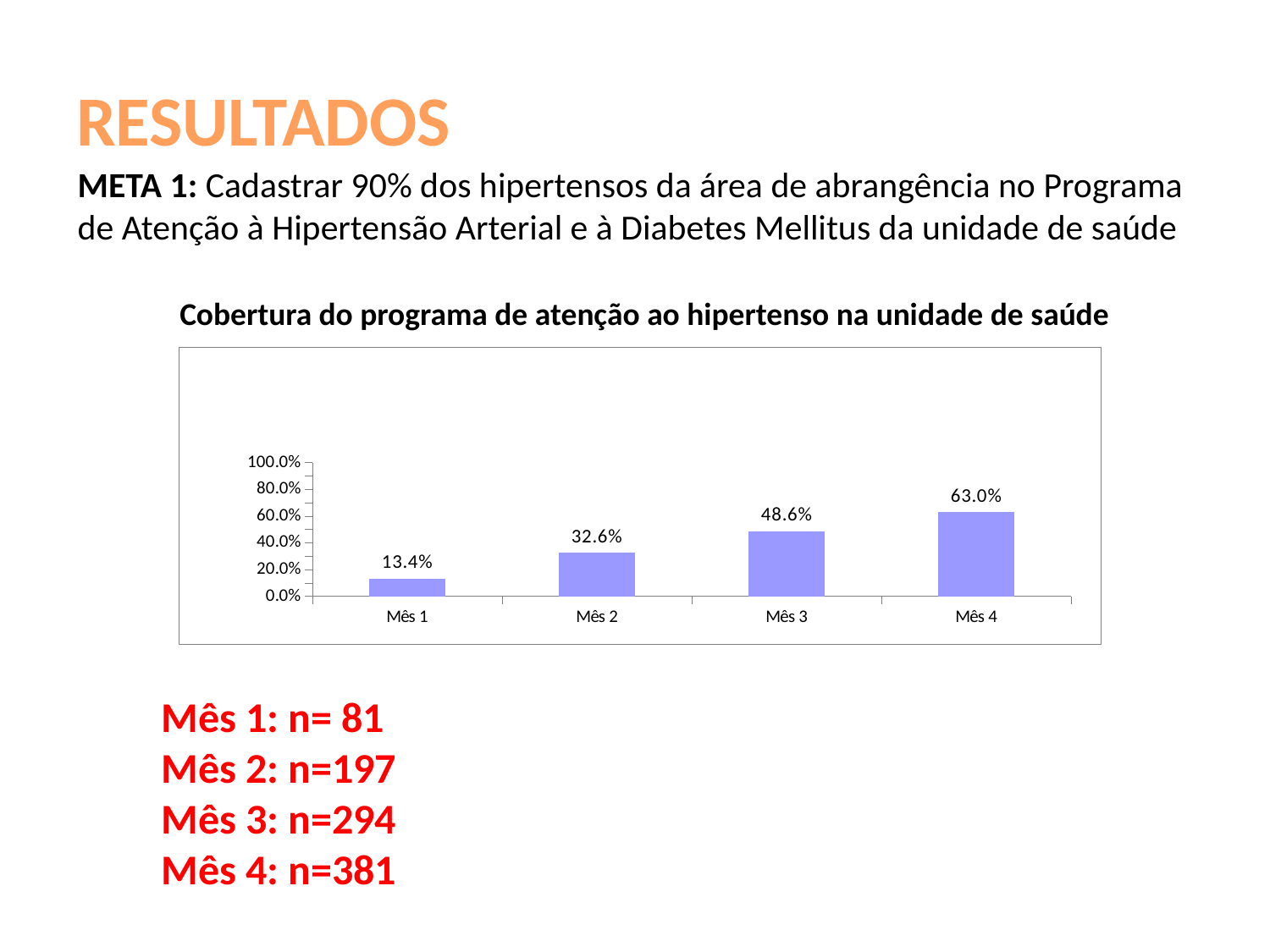
What is the value for Mês 4? 63.0% Which month has the lowest value? Mês 1 What is the value for Mês 1? 13.4% Which month has the highest value? Mês 4 Is the value for Mês 4 greater or less than 80.0%? less Which is larger, the value for Mês 2 or the value for Mês 3? Mês 3 How many months are shown on the x axis? 4 What kind of chart is shown? bar chart What is the difference between the values for Mês 4 and Mês 1? 49.6% Do the values rise or fall from Mês 1 to Mês 4? rise What is the value for Mês 3? 48.6% What is the value for Mês 2? 32.6%